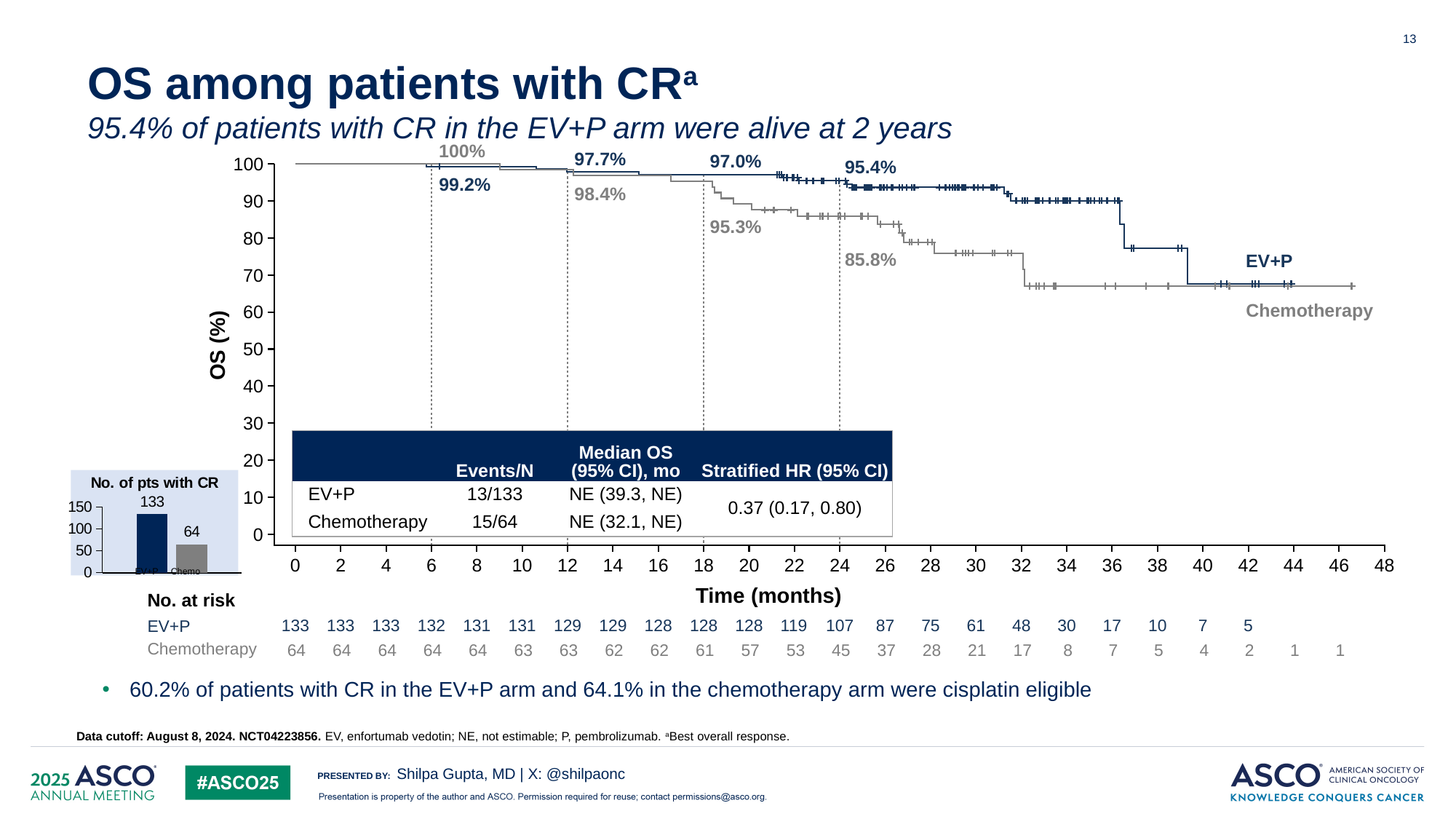
What kind of chart is the small 'No. of pts with CR' chart? bar chart In the 'No. of pts with CR' chart, what is the value for EV+P? 133 In the OS chart, what is the OS for the Chemotherapy arm at 6 months? 100% In the OS chart, what is the OS for the Chemotherapy arm at 24 months? 85.8% In the OS chart, which arm has the higher OS at 18 months? EV+P In the OS chart, what is the OS for the EV+P arm at 12 months? 97.7% In the OS chart, what is the OS for the EV+P arm at 24 months? 95.4% In the OS chart, what is the difference in OS between the EV+P and Chemotherapy arms at 24 months? 9.6 percentage points In the OS chart, do the survival curves rise or fall as time increases? fall In the 'No. of pts with CR' chart, what is the difference between the EV+P and Chemo values? 69 How many treatment arms are plotted in the OS chart? 2 In the OS chart, is the Chemotherapy curve at 40 months greater or less than 70? less